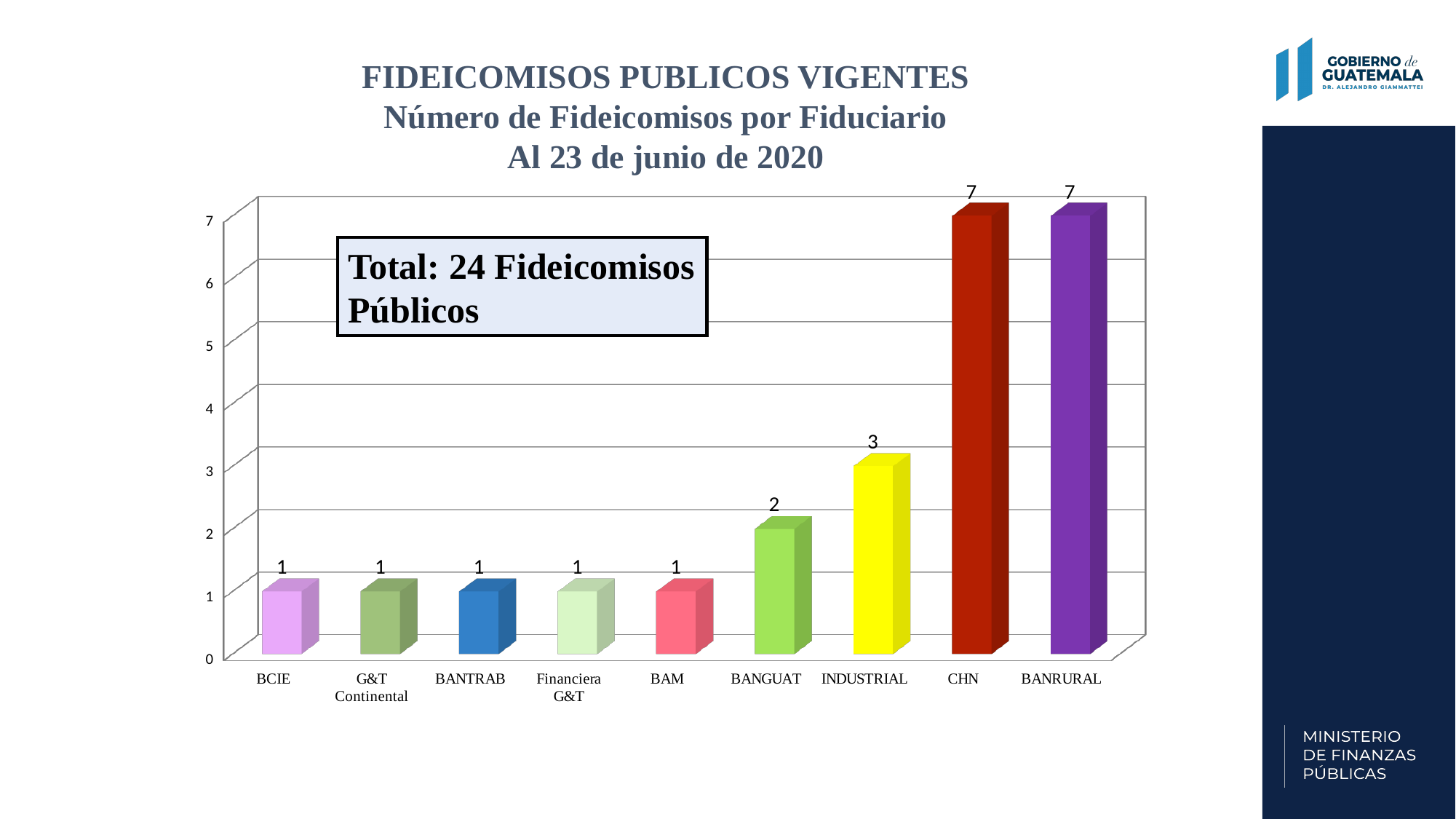
What total is stated in the text box on the chart? Total: 24 Fideicomisos Públicos What kind of chart is shown on the slide? bar chart Is the value for CHN greater or less than 5? greater Which category has the lowest value among BAM, BANGUAT and INDUSTRIAL? BAM How many categories are shown on the x axis? 9 What is the difference between the values for BANGUAT and BANTRAB? 1 What is the value for BCIE? 1 What is the value for BANGUAT? 2 What is the difference between the values for BANRURAL and INDUSTRIAL? 4 Which is larger, the value for INDUSTRIAL or the value for BANGUAT? INDUSTRIAL What is the value for CHN? 7 What is the value for INDUSTRIAL? 3